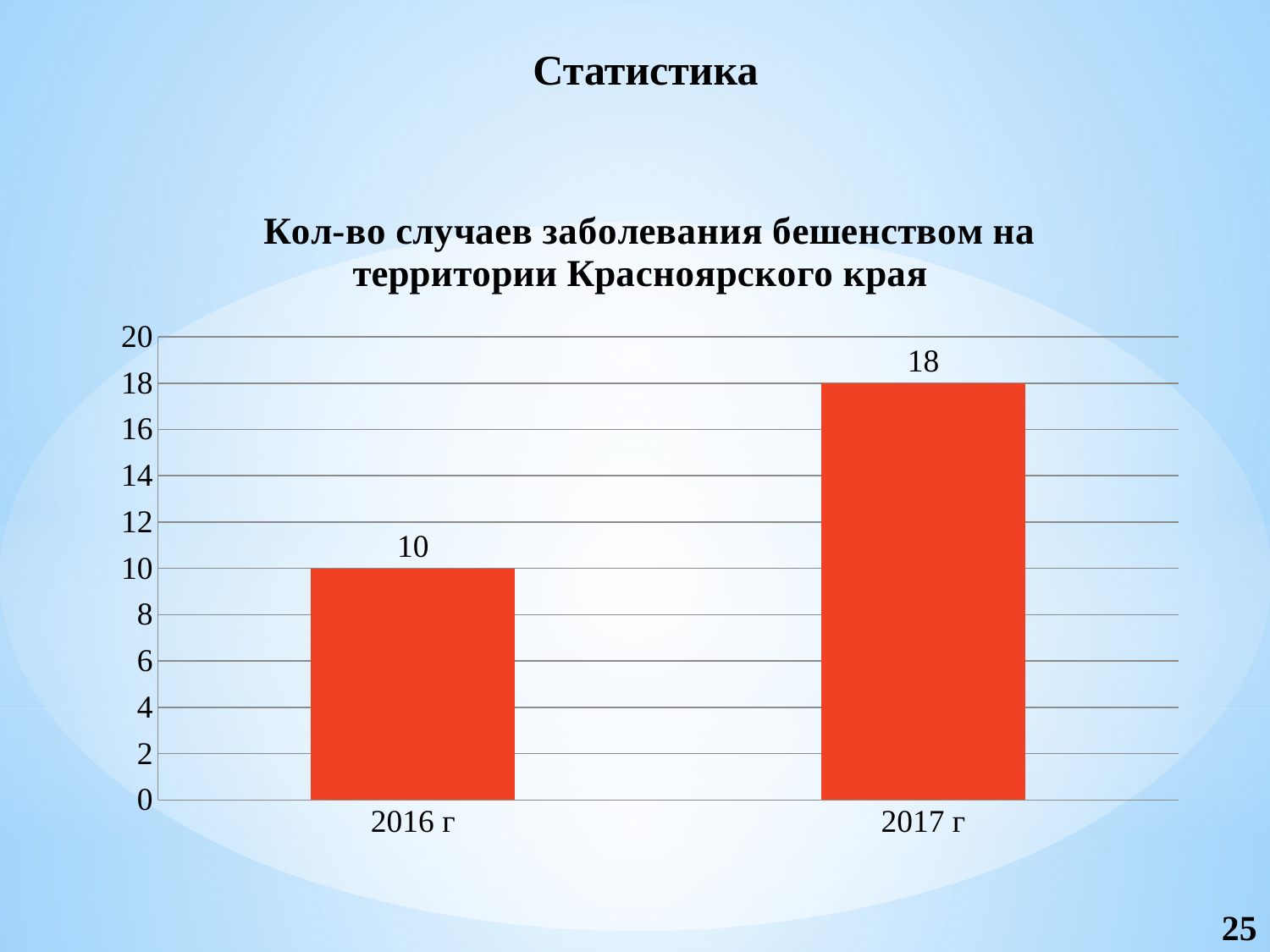
How many categories are shown on the x axis? 2 Which year has the lowest number of cases? 2016 г Is the value for 2017 г greater or less than 16? greater What is the number of rabies cases for 2016 г? 10 Is the value for 2016 г greater or less than 12? less What is the title of the chart? Кол-во случаев заболевания бешенством на территории Красноярского края What is the difference between the values for 2017 г and 2016 г? 8 Which is larger, the value for 2016 г or the value for 2017 г? 2017 г What is the number of rabies cases for 2017 г? 18 Which year has the highest number of cases? 2017 г What kind of chart is shown on the slide? bar chart Do the values rise or fall from 2016 г to 2017 г? rise